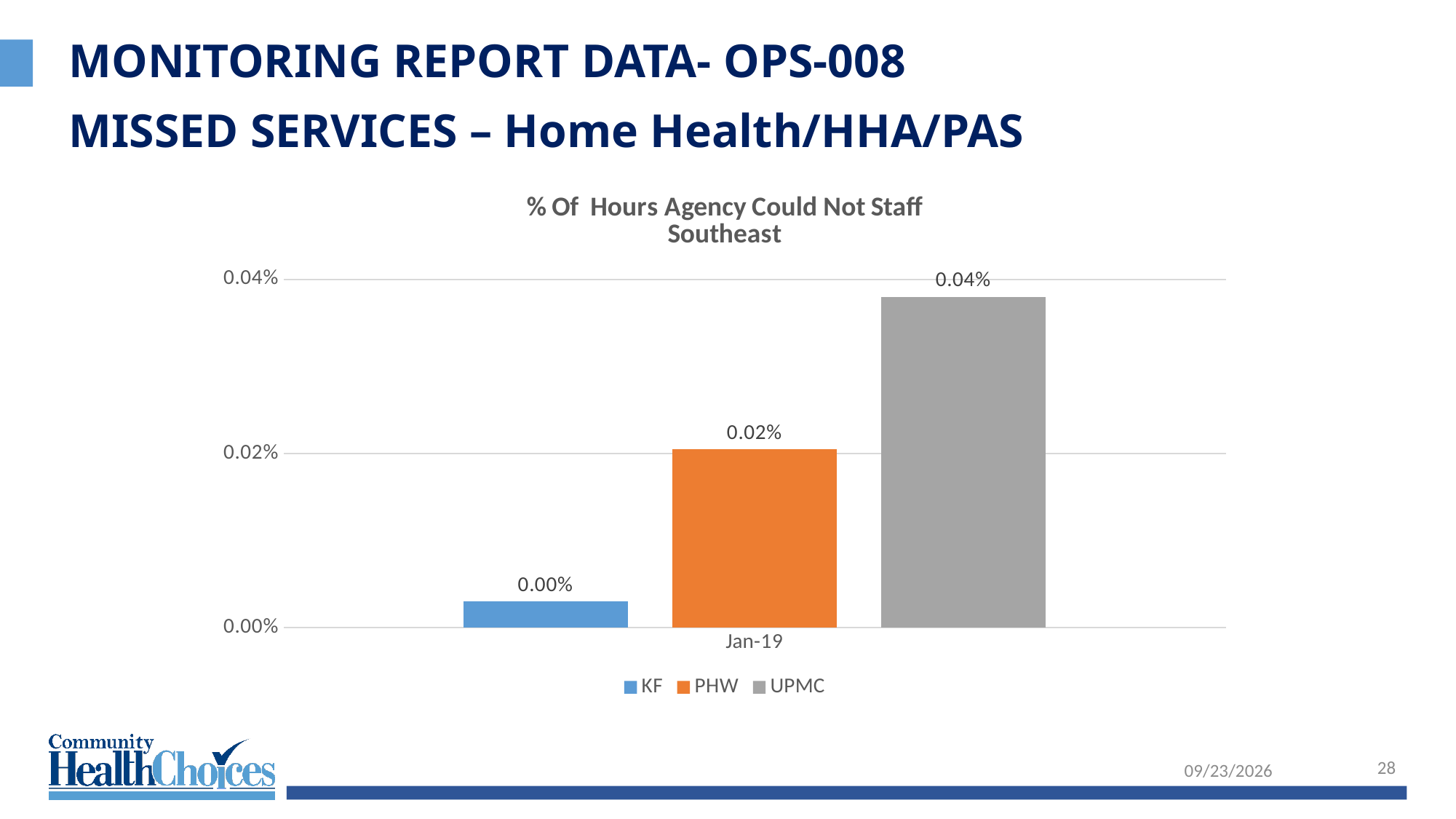
What kind of chart is shown on the slide? bar chart Which series has the lowest value in Jan-19? KF Is the value for KF greater or less than 0.02%? less How many series does the legend list? 3 Which series has the highest value in Jan-19? UPMC What is the value for UPMC in Jan-19? 0.04% Which is larger in Jan-19, the value for PHW or the value for KF? PHW Is the value for UPMC greater or less than 0.02%? greater What is the value for KF in Jan-19? 0.00% What is the difference between the UPMC and PHW values in Jan-19? 0.02% What is the title of the chart? % Of Hours Agency Could Not Staff Southeast What is the value for PHW in Jan-19? 0.02%